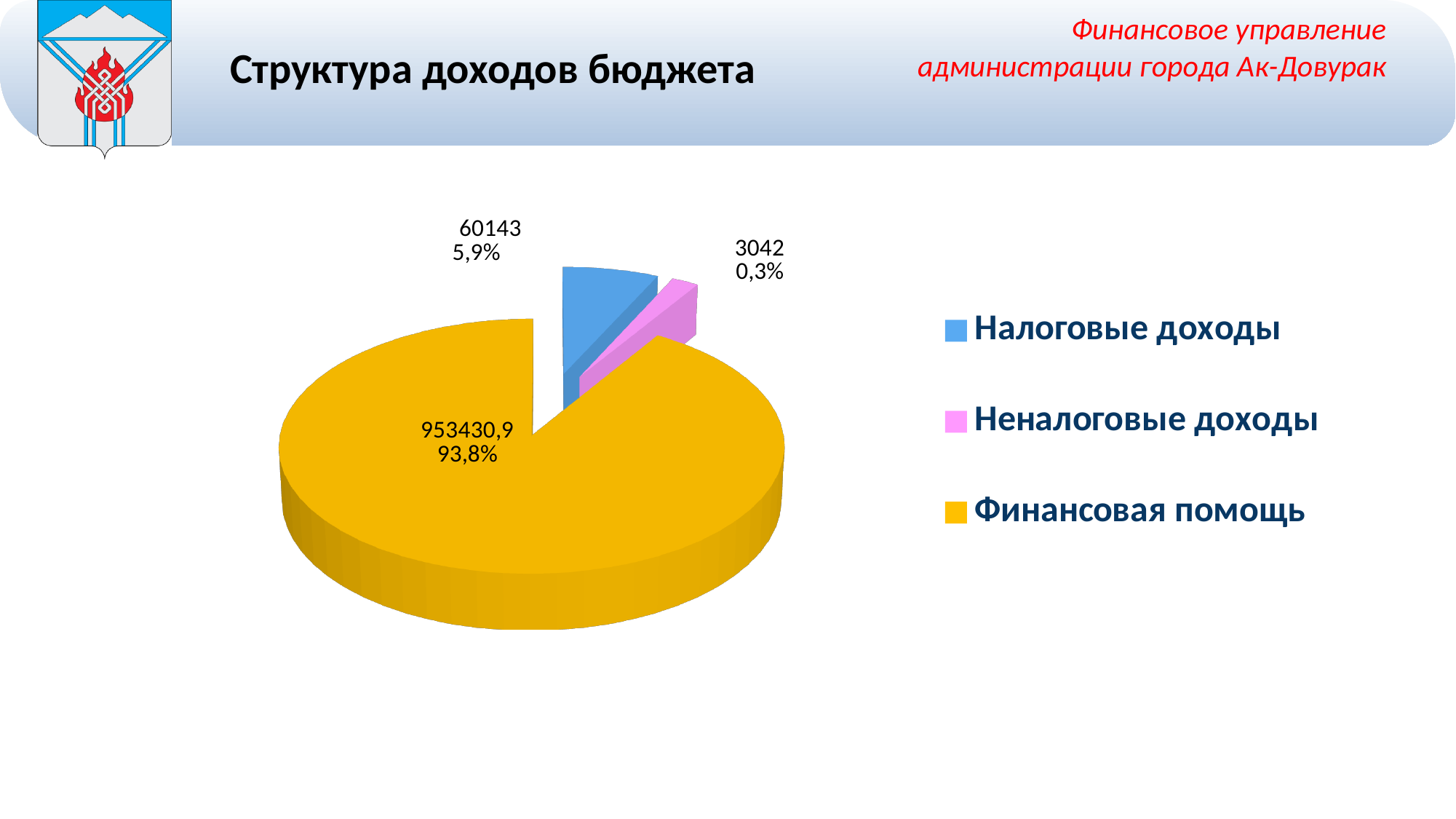
What share of the pie does Налоговые доходы take? 5,9% What is the value for Налоговые доходы? 60143 Which is larger, Налоговые доходы or Неналоговые доходы? Налоговые доходы What share of the pie does Неналоговые доходы take? 0,3% What is the value for Финансовая помощь? 953430,9 What is the difference between the values for Налоговые доходы and Неналоговые доходы? 57101 What is the value for Неналоговые доходы? 3042 What share of the pie does Финансовая помощь take? 93,8% How many categories does the pie chart have? 3 What kind of chart is shown on the slide? Pie chart Which category has the largest slice? Финансовая помощь Which category has the smallest slice? Неналоговые доходы